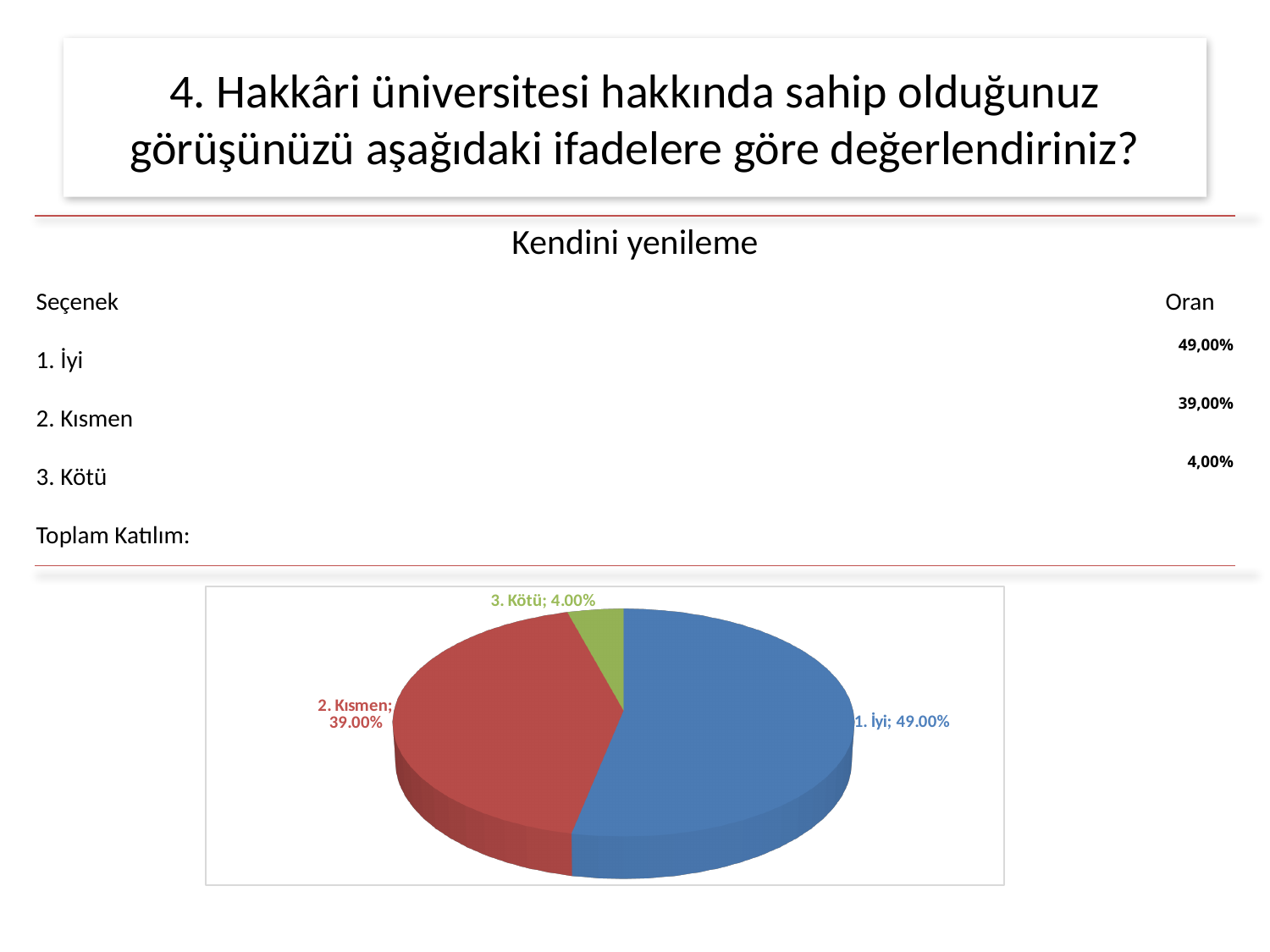
Which is larger in the pie chart, the value for "2. Kısmen" or the value for "3. Kötü"? 2. Kısmen Which slice of the pie chart is the smallest? 3. Kötü What colour is the "3. Kötü" slice in the pie chart? green How many slices does the pie chart have? 3 What is the value shown for the slice "3. Kötü" in the pie chart? 4.00% What colour is the "1. İyi" slice in the pie chart? blue What is the value shown for the slice "1. İyi" in the pie chart? 49.00% What is the value shown for the slice "2. Kısmen" in the pie chart? 39.00% What kind of chart is shown on the slide? pie chart What is the difference between the values for "2. Kısmen" and "3. Kötü" in the pie chart? 35.00% What is the difference between the values for "1. İyi" and "2. Kısmen" in the pie chart? 10.00% Which slice of the pie chart is the largest? 1. İyi